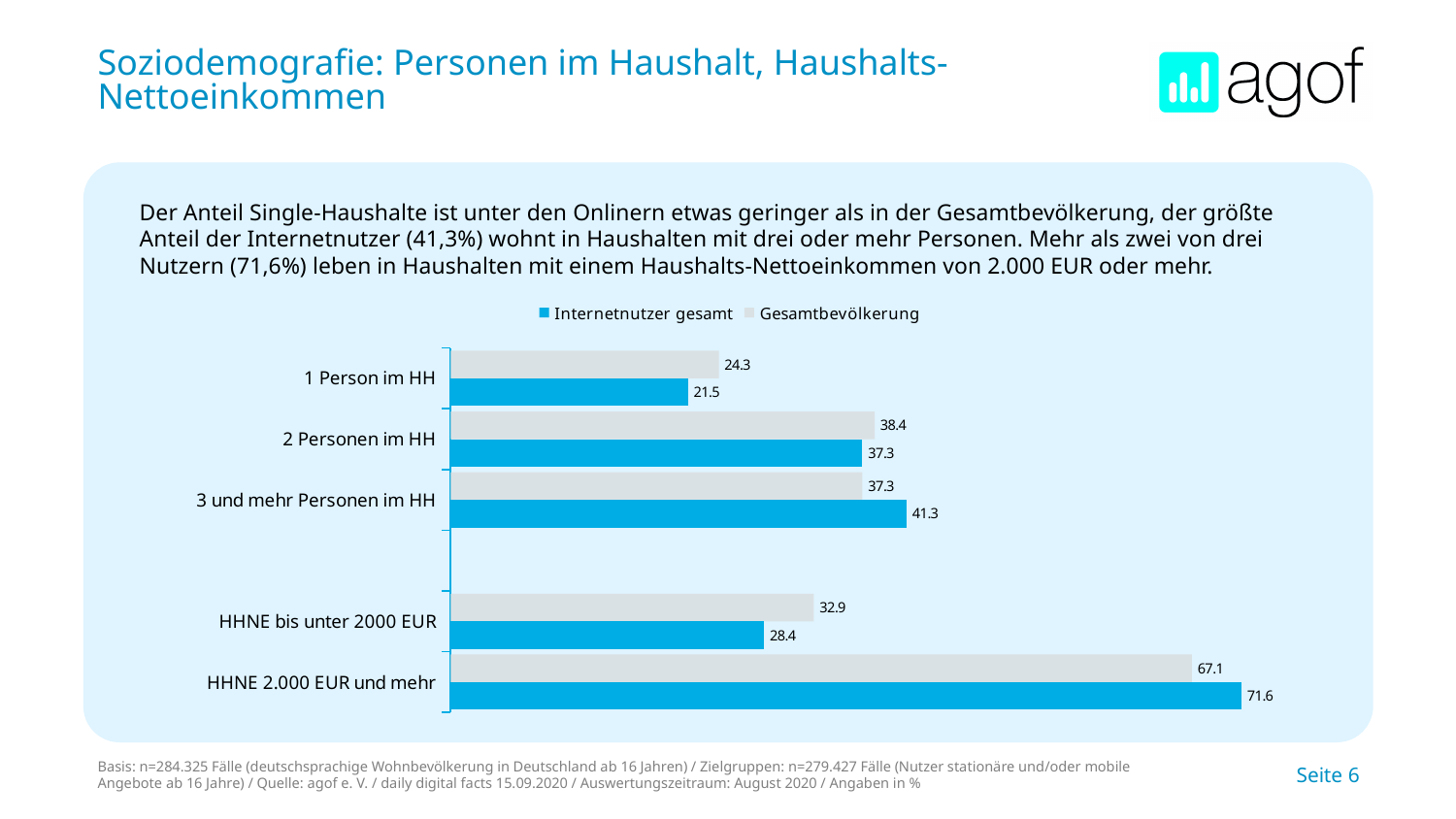
In the category '3 und mehr Personen im HH', which series has the larger value, Internetnutzer gesamt or Gesamtbevölkerung? Internetnutzer gesamt What is the value for Internetnutzer gesamt in the category 'HHNE 2.000 EUR und mehr'? 71.6 Which category has the highest value for Gesamtbevölkerung? HHNE 2.000 EUR und mehr What is the difference between Internetnutzer gesamt and Gesamtbevölkerung in the category 'HHNE bis unter 2000 EUR'? 4.5 How many categories are shown on the chart? 5 What is the difference between Internetnutzer gesamt and Gesamtbevölkerung in the category 'HHNE 2.000 EUR und mehr'? 4.5 Which category has the lowest value for Internetnutzer gesamt? 1 Person im HH What kind of chart is shown on the slide? Bar chart In the category '2 Personen im HH', which series has the larger value, Internetnutzer gesamt or Gesamtbevölkerung? Gesamtbevölkerung How many series does the legend list? 2 What is the value for Internetnutzer gesamt in the category '3 und mehr Personen im HH'? 41.3 What is the value for Gesamtbevölkerung in the category '1 Person im HH'? 24.3